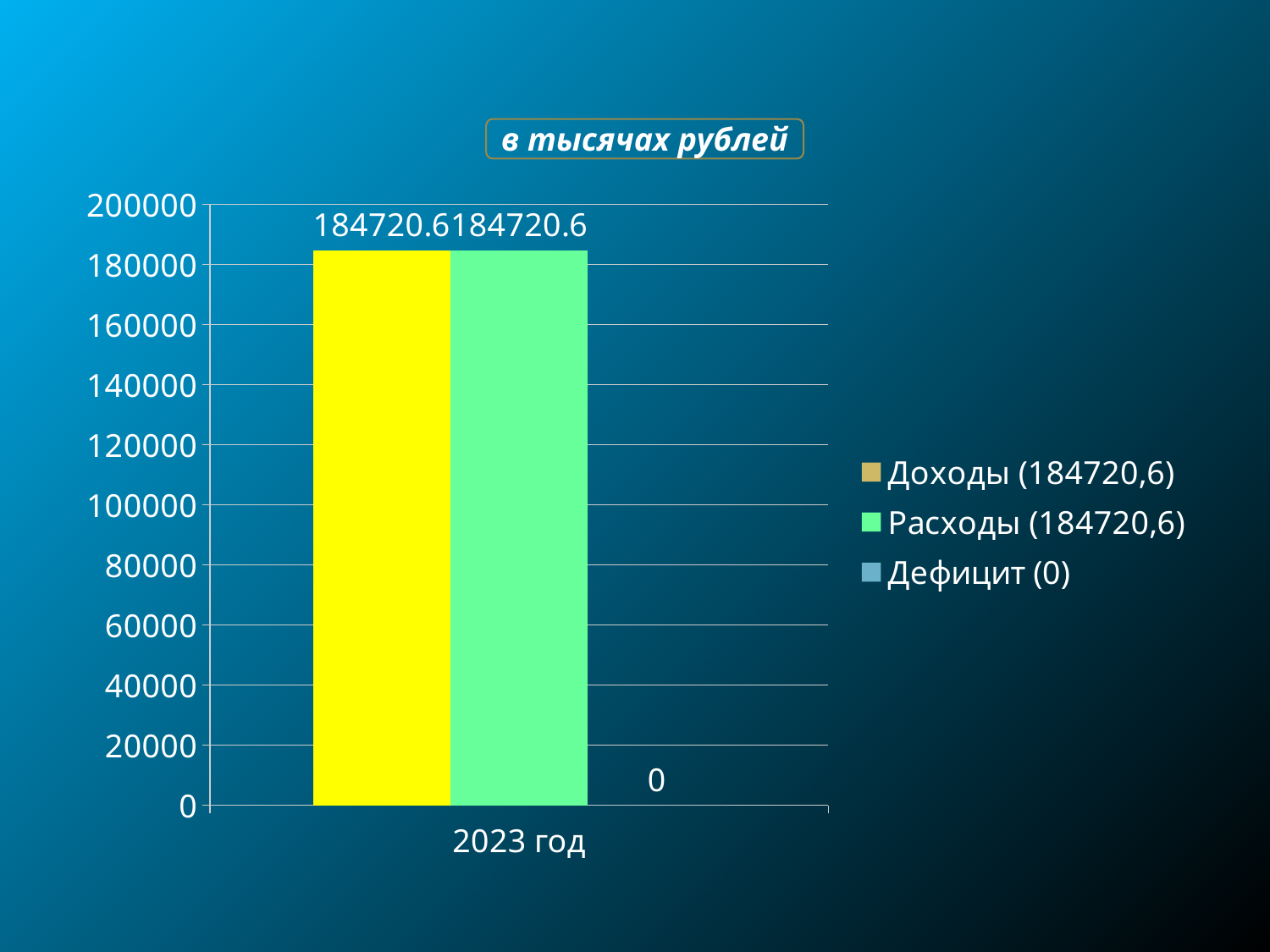
What is the value of the Доходы bar for 2023 год? 184720.6 What is the title of the chart? в тысячах рублей What is the difference between the Доходы and Расходы values for 2023 год? 0 Is the value for Расходы in 2023 год greater or less than 200000? less What is the value shown for Дефицит in 2023 год? 0 What colour is the Расходы bar? green Is the value for Доходы in 2023 год greater or less than 180000? greater Which series has the lowest value for 2023 год? Дефицит How many series does the legend list? 3 What kind of chart is shown on the slide? bar chart How many categories are shown on the x axis? 1 What is the value of the Расходы bar for 2023 год? 184720.6